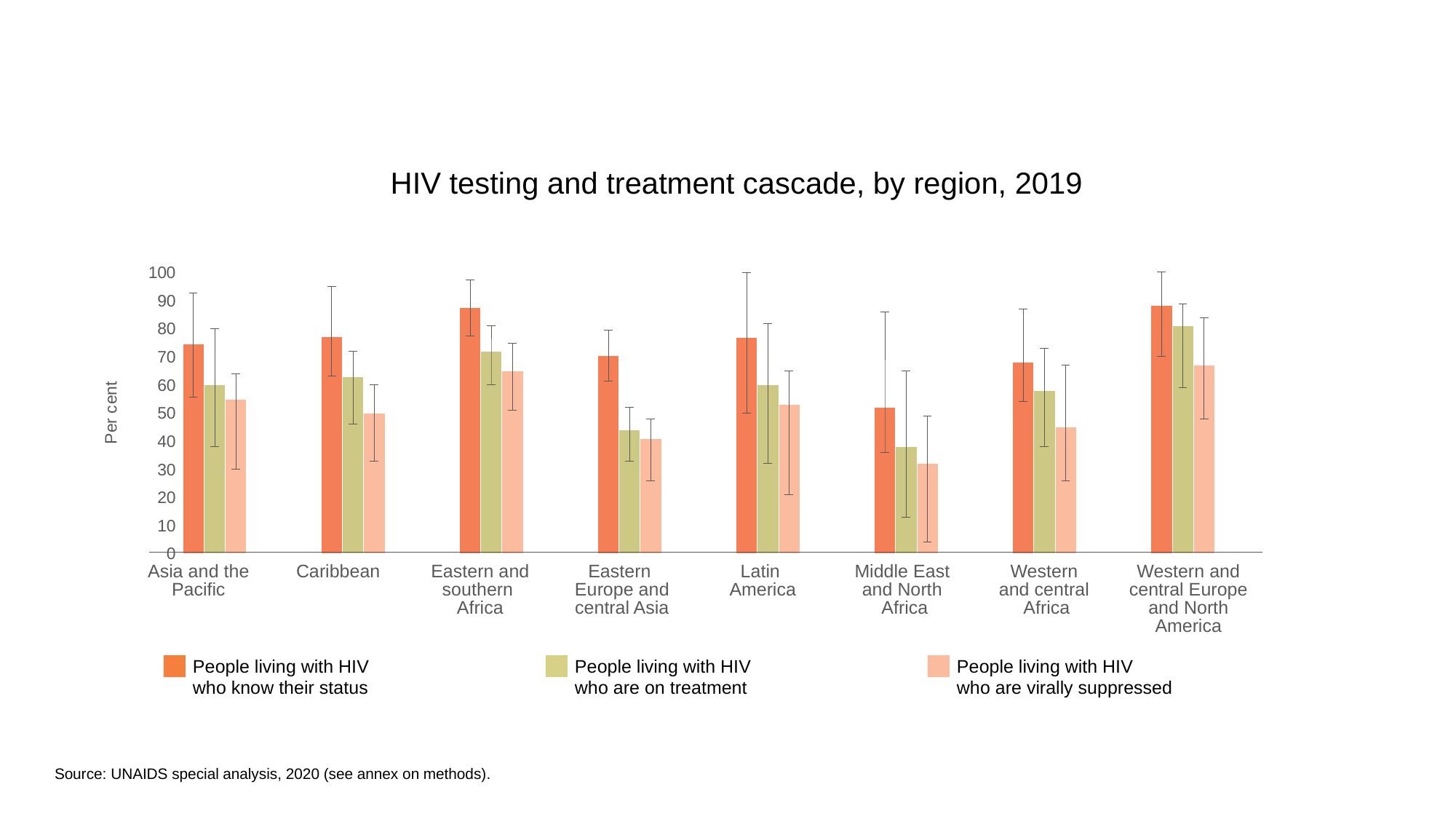
How many regions are shown on the x axis? 8 How many series does the legend list? 3 Is the value for people living with HIV who are on treatment in Eastern Europe and central Asia greater or less than 50? less Which region has the lowest value for people living with HIV who know their status? Middle East and North Africa Is the value for people living with HIV who are on treatment in Western and central Europe and North America greater or less than 70? greater Which region has the lowest value for people living with HIV who are virally suppressed? Middle East and North Africa Which region has the highest value for people living with HIV who are on treatment? Western and central Europe and North America Is the value for people living with HIV who know their status in Eastern and southern Africa greater or less than 80? greater What is the label on the vertical axis? Per cent Which is larger: people living with HIV who are on treatment in Eastern and southern Africa or in the Caribbean? Eastern and southern Africa What kind of chart is shown on the slide? Bar chart